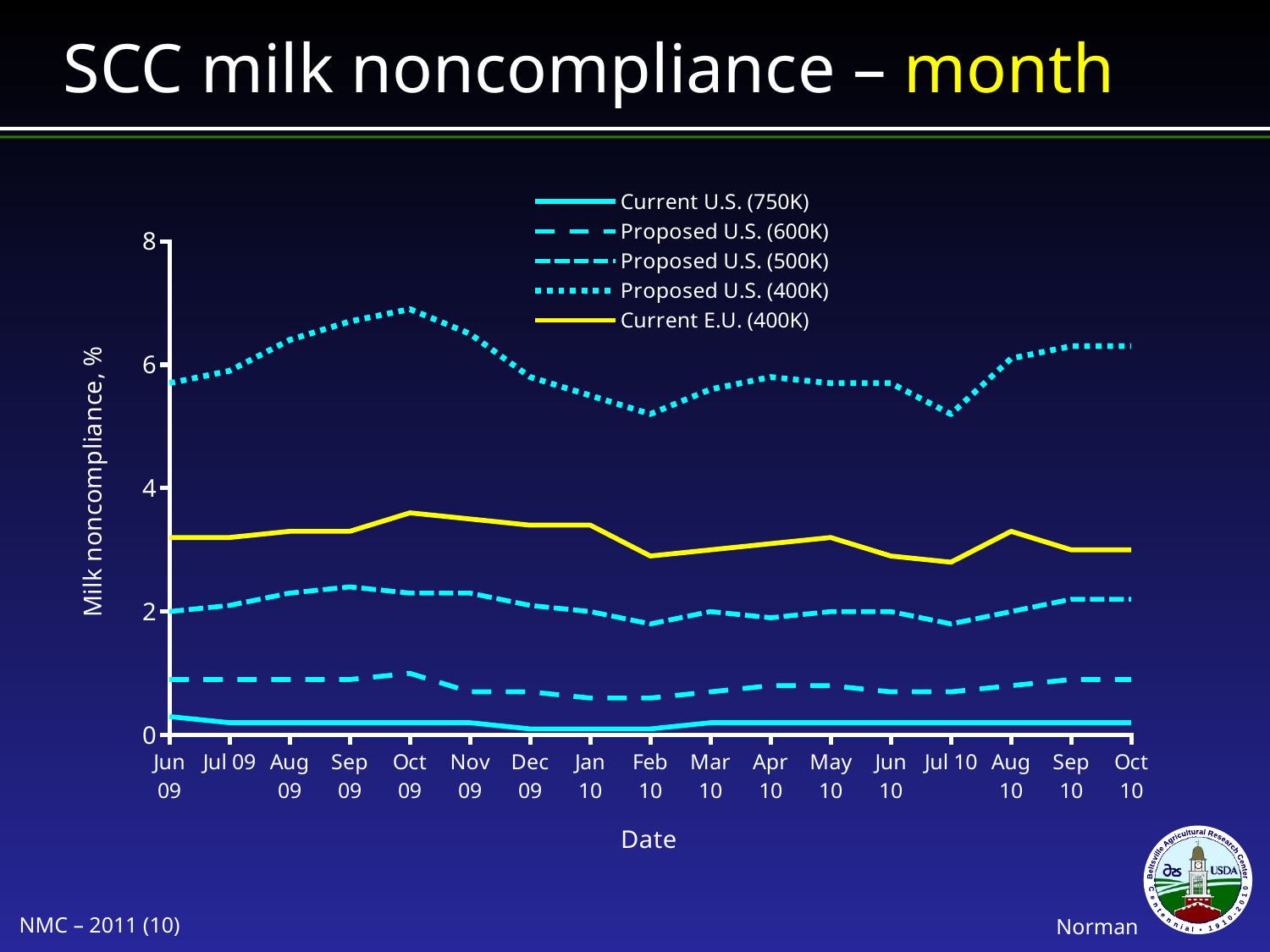
What kind of chart is shown on the slide? line chart Is the value for Current E.U. (400K) in Feb 10 greater or less than 4? less Is the value for Proposed U.S. (400K) in Oct 09 greater or less than 6? greater In which month does the Proposed U.S. (400K) series reach its highest value? Oct 09 How many months are shown along the x axis? 17 How many series does the legend list? 5 Is the value for Proposed U.S. (600K) in Jan 10 greater or less than 2? less Which series has the lowest milk noncompliance across the whole period? Current U.S. (750K) In Jun 09, which is larger: Proposed U.S. (400K) or Current E.U. (400K)? Proposed U.S. (400K) Does the Proposed U.S. (400K) series rise or fall from Oct 09 to Feb 10? fall Which series has the highest milk noncompliance across the whole period? Proposed U.S. (400K) What is the label on the y axis? Milk noncompliance, %